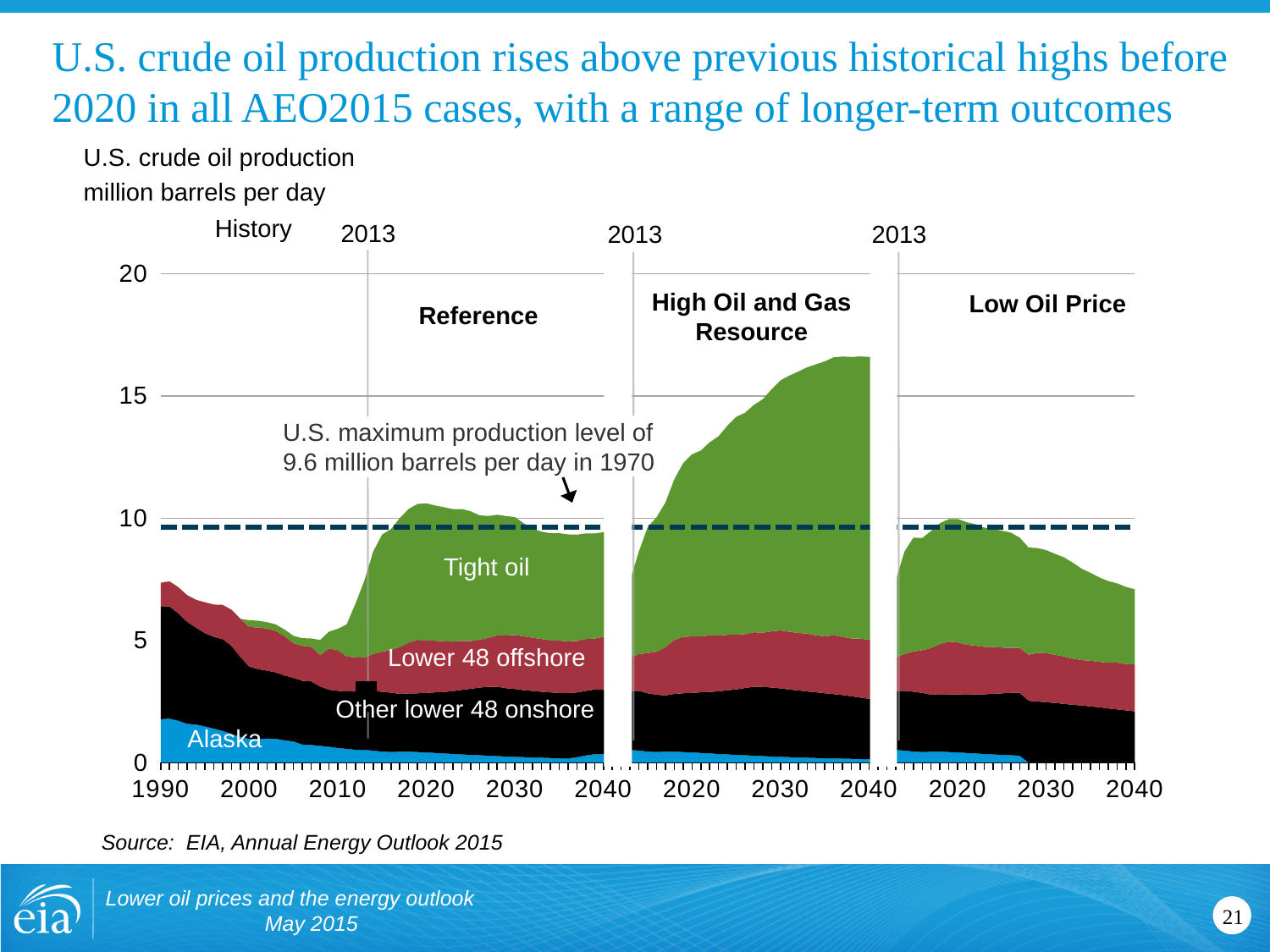
In the Low Oil Price case, does total production rise or fall from 2020 to 2040? fall In the High Oil and Gas Resource case, is total production in 2040 greater or less than 15 million barrels per day? greater What unit is U.S. crude oil production measured in on this chart? million barrels per day What kind of chart is shown on the slide? Stacked area chart Which case shows the lowest total crude oil production in 2040? Low Oil Price Which production component is shown in green on the chart? Tight oil In the High Oil and Gas Resource case, does total production rise or fall from 2013 to 2040? rise How many projection cases (panels) are shown on the chart? 3 How many production components (series) are labeled in the stacked areas? 4 Which case shows the highest total crude oil production in 2040? High Oil and Gas Resource What U.S. maximum production level in 1970 does the dashed line mark? 9.6 million barrels per day In the Low Oil Price case, is total production in 2040 greater or less than 10 million barrels per day? less